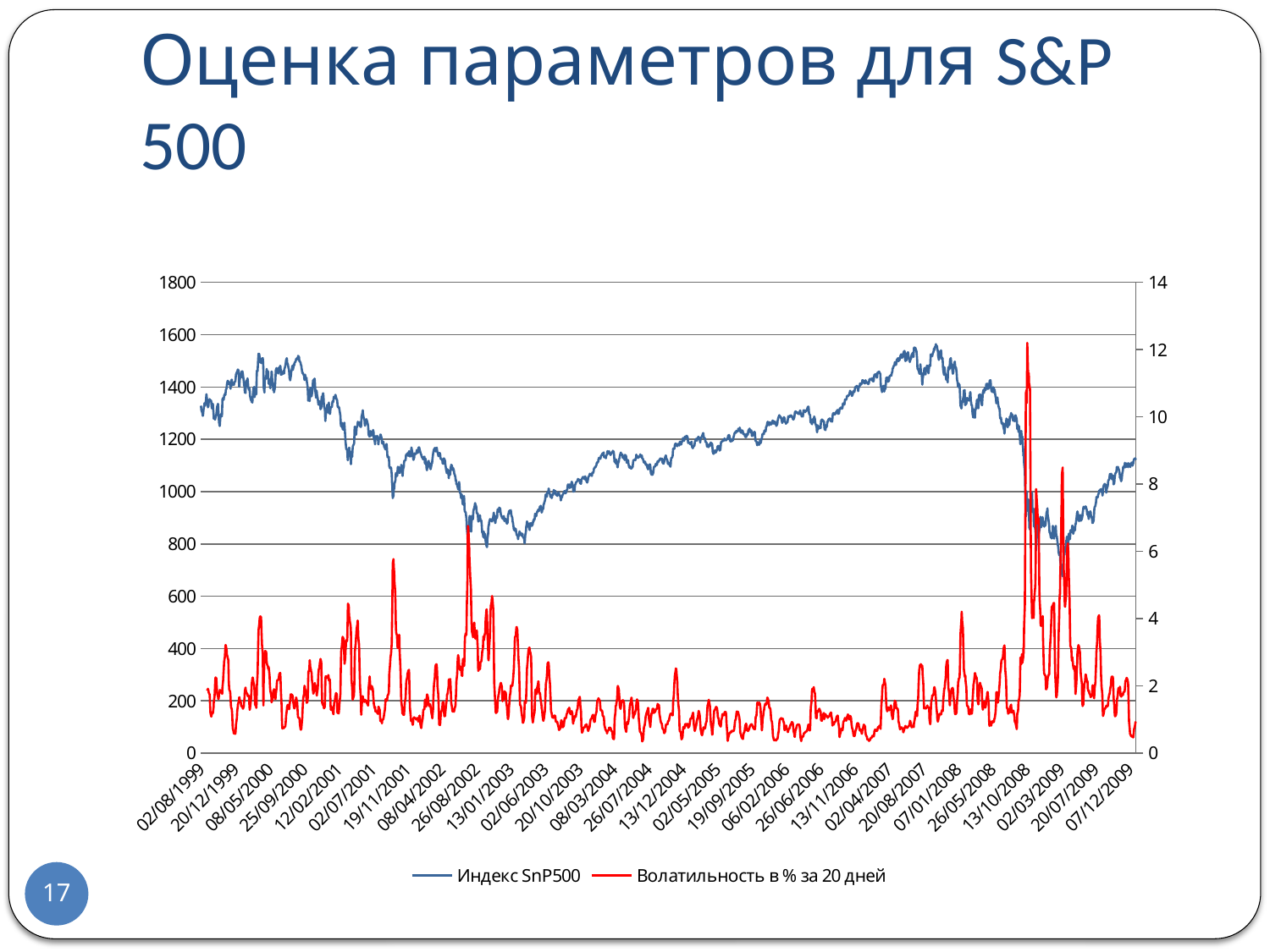
Is the value of Индекс SnP500 around 20/08/2007 greater or less than 1400? greater Does Индекс SnP500 rise or fall between 13/01/2003 and 20/08/2007? rise Is the highest peak of Волатильность в % за 20 дней greater or less than 10 on the right axis? greater How many series does the legend list? 2 Is the value of Индекс SnP500 at 02/08/1999 greater or less than 1200? greater Does Индекс SnP500 rise or fall between 07/01/2008 and 13/10/2008? fall What kind of chart is shown on the slide? line chart What colour is the line for Волатильность в % за 20 дней? red What are the two series named in the legend? Индекс SnP500 and Волатильность в % за 20 дней